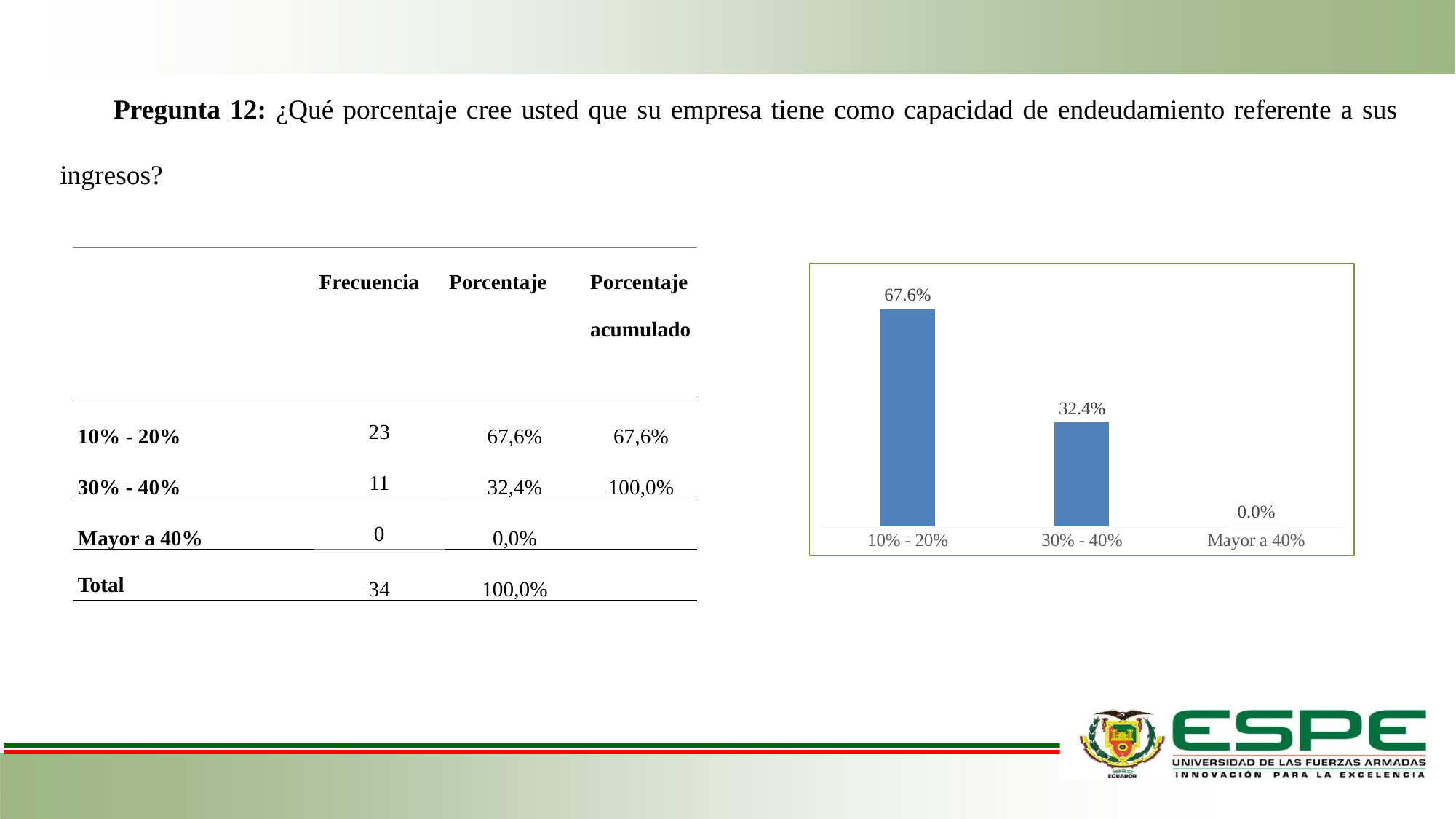
How many categories are shown in the bar chart? 3 Which is larger in the bar chart, the value for 10% - 20% or the value for 30% - 40%? 10% - 20% What is the value for the Mayor a 40% category in the bar chart? 0.0% What is the total of the three values shown in the bar chart? 100.0% What kind of chart is shown on the slide? Bar chart What is the value for the 30% - 40% category in the bar chart? 32.4% What is the value for the 10% - 20% category in the bar chart? 67.6% What colour are the bars in the chart? Blue Do the values in the bar chart rise or fall from left to right along the x axis? Fall Which category has the highest value in the bar chart? 10% - 20% Which category has the lowest value in the bar chart? Mayor a 40% What is the difference between the values for 10% - 20% and 30% - 40% in the bar chart? 35.2%